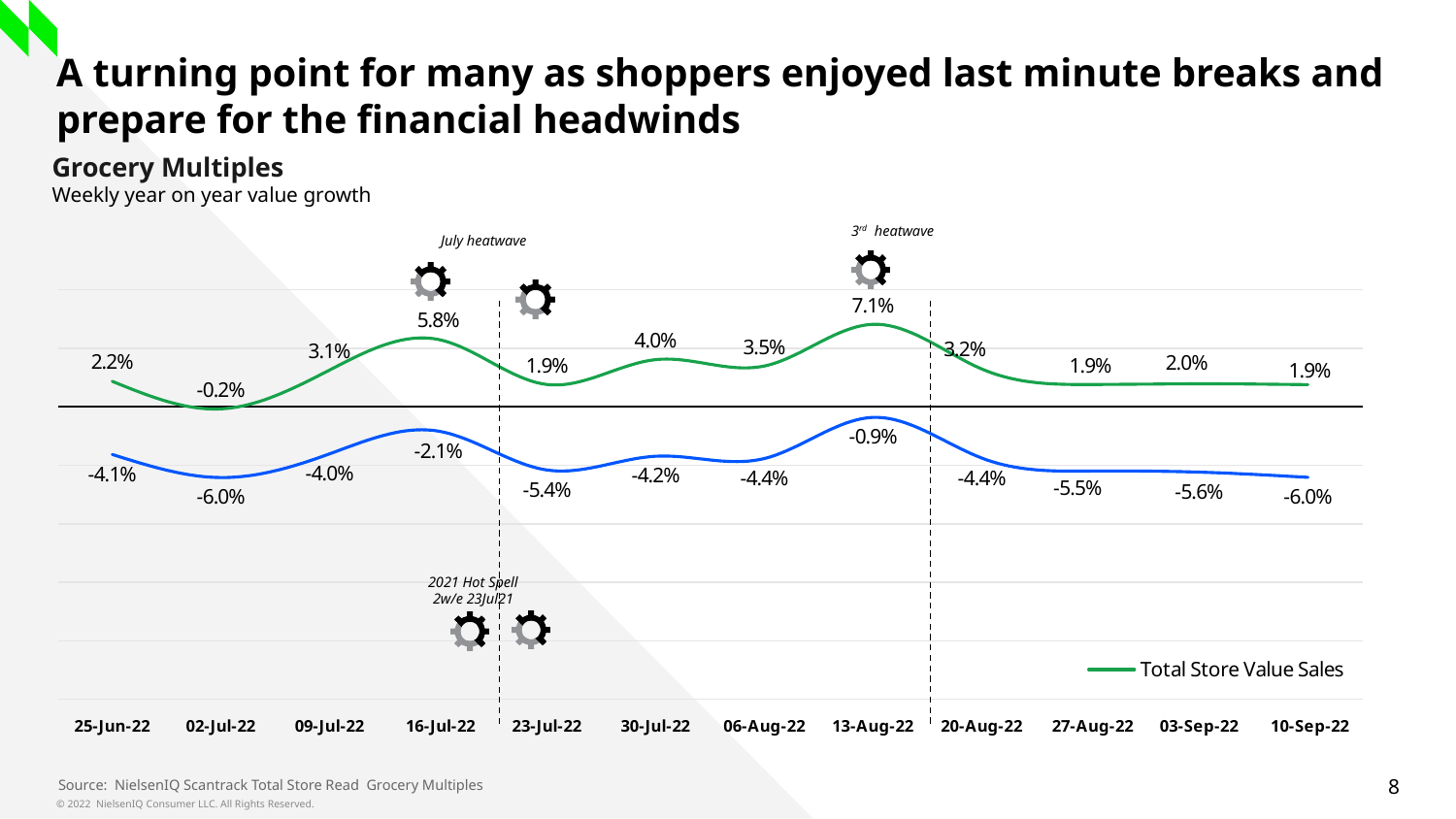
Which is larger, the Total Store Value Sales growth for 16-Jul-22 or for 30-Jul-22? 16-Jul-22 Which week has the highest Total Store Value Sales growth? 13-Aug-22 What is the value shown on the blue line for 10-Sep-22? -6.0% What is the value shown on the blue line for 16-Jul-22? -2.1% What is the Total Store Value Sales growth for 02-Jul-22? -0.2% What is the difference between the Total Store Value Sales growth for 13-Aug-22 and 20-Aug-22? 3.9 percentage points What kind of chart is shown on the slide? Line chart Which week has the lowest Total Store Value Sales growth? 02-Jul-22 How many series does the legend list? 1 How many weekly data points are plotted on the x axis? 12 Does the Total Store Value Sales growth rise or fall from 13-Aug-22 to 27-Aug-22? Fall What is the Total Store Value Sales growth for 13-Aug-22? 7.1%